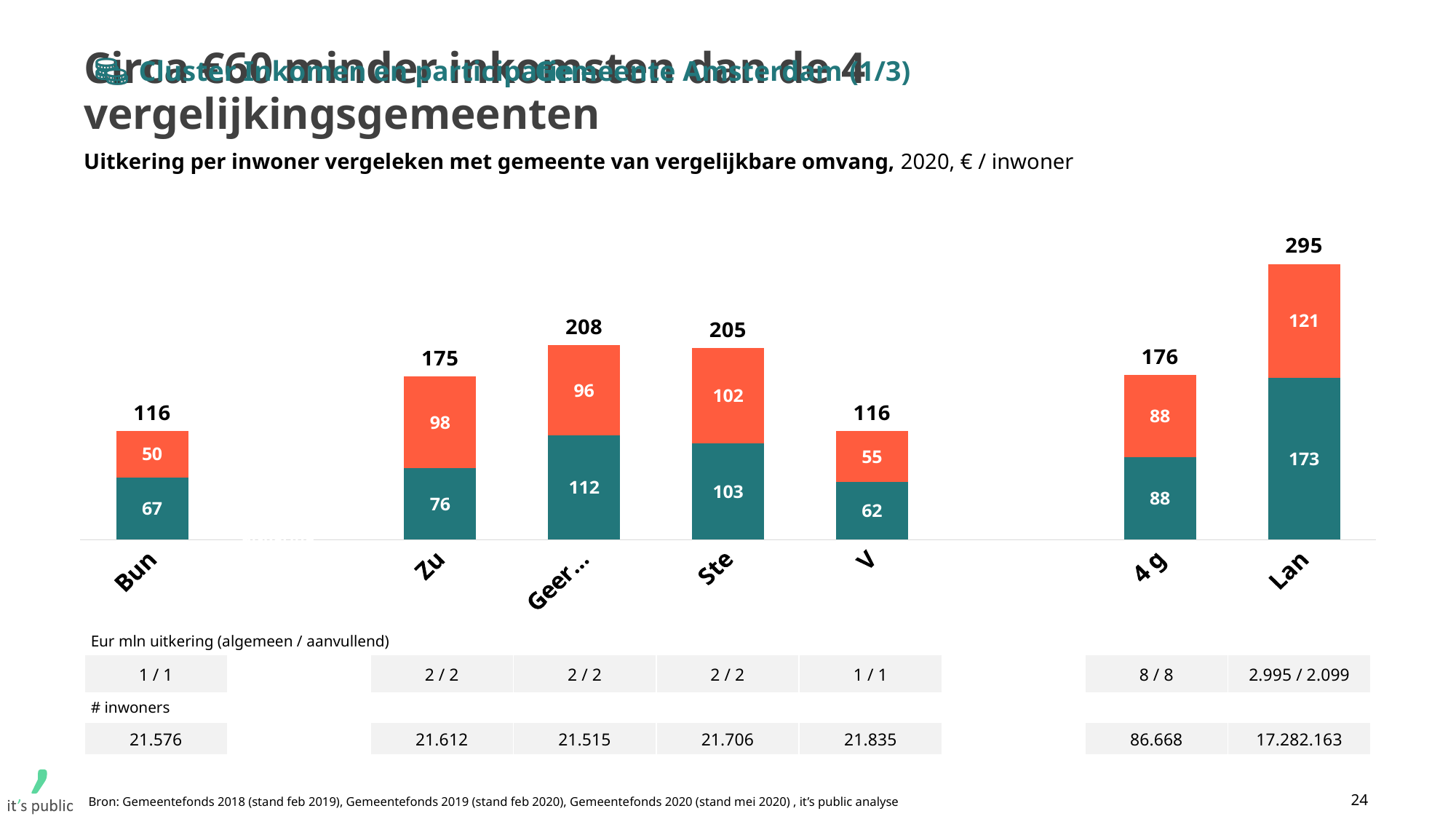
What is the difference between the dark teal segment for Lan and the dark teal segment for 4 g? 85 What kind of chart is shown on the slide? Stacked bar chart What is the difference between the total for Lan and the total for Bun? 179 What is the total value shown above the bar for 4 g? 176 Which has a larger orange (top) segment, Zu or V? Zu Which category has the highest total value? Lan What is the value of the dark teal (bottom) segment for Bun? 67 Which has a larger total, Geer… or Ste? Geer… What is the value of the dark teal (bottom) segment for Geer…? 112 What is the value of the orange (top) segment for Lan? 121 What is the total value shown above the bar for Lan? 295 What is the value of the orange (top) segment for Ste? 102